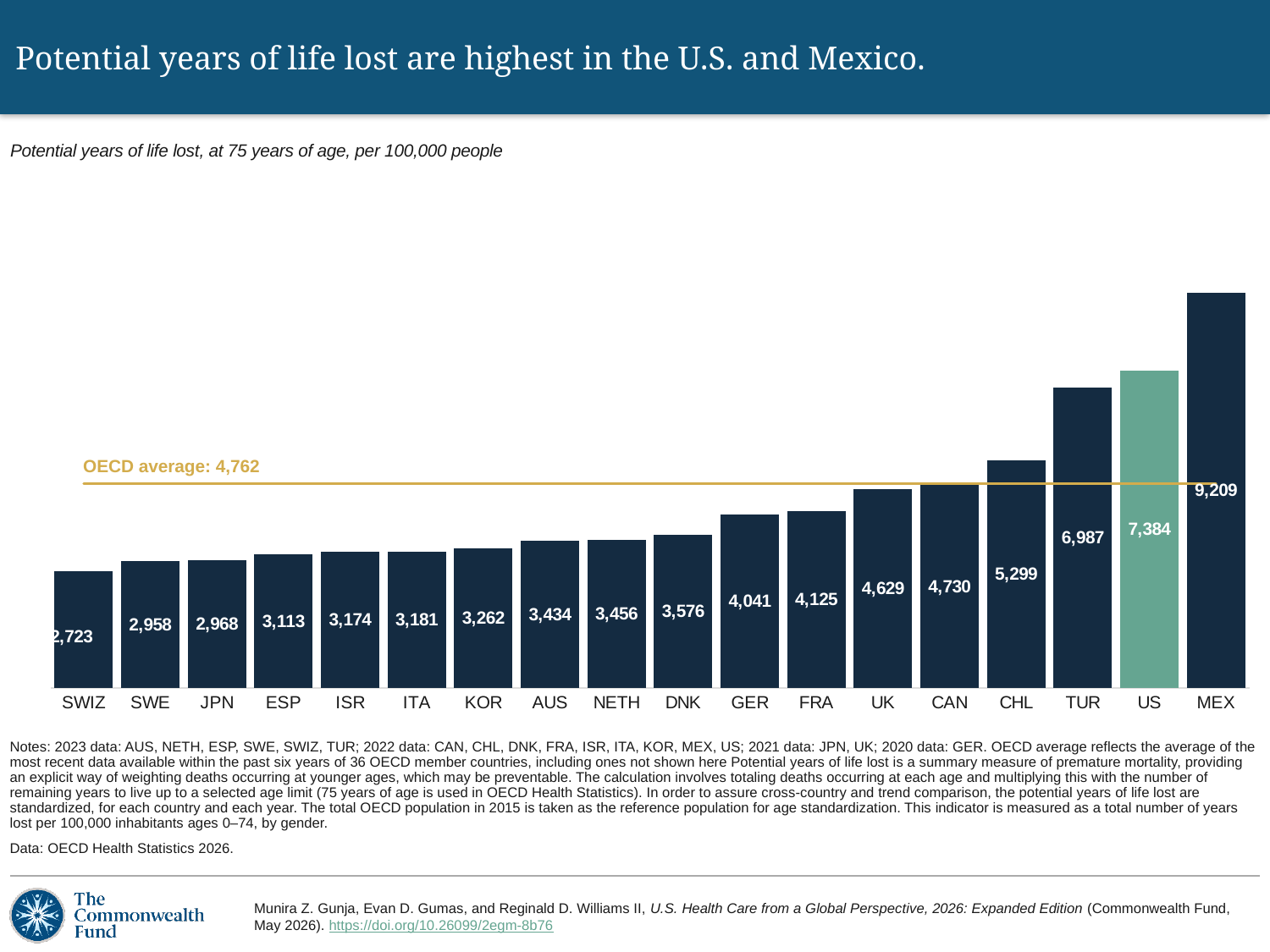
What is the value for Chile (CHL)? 5,299 What type of chart is shown on the slide? Bar chart Which country has the highest potential years of life lost? MEX Do the values rise or fall moving from left to right across the chart? Rise What is the value for the US? 7,384 Which country has the lowest potential years of life lost? SWIZ What is the difference between the values for Turkey (TUR) and Canada (CAN)? 2,257 What is the difference between the values for Mexico (MEX) and the US? 1,825 Which is larger, the value for the UK or the value for France (FRA)? UK What is the OECD average shown on the chart? 4,762 How many countries are shown in the chart? 18 What is the value for Germany (GER)? 4,041